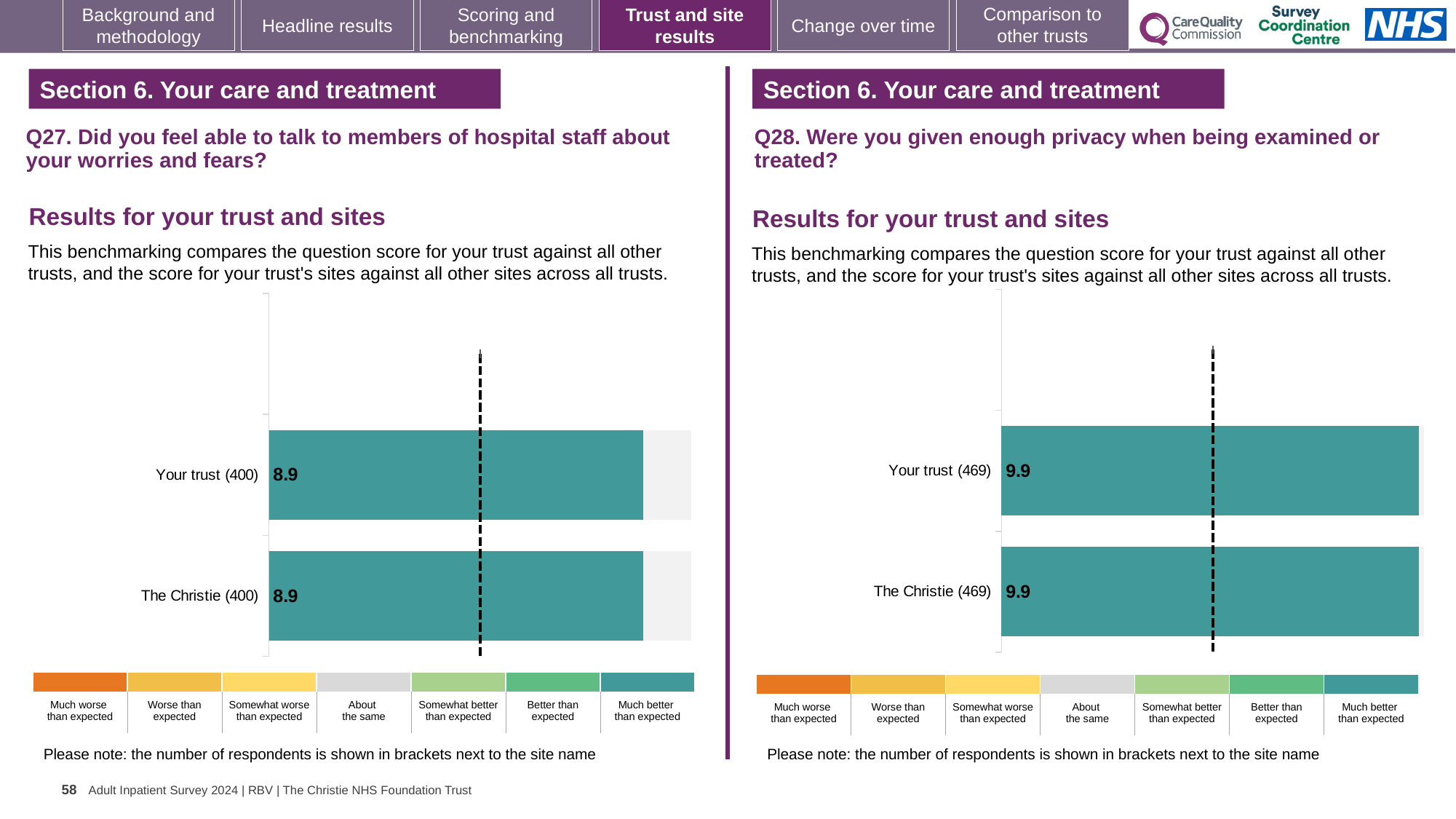
In the Q28 chart on the right, how many respondents are shown in brackets next to Your trust? 469 In the Q28 chart on the right, what is the difference between the score for Your trust and the score for The Christie? 0.0 How many bars are plotted in the Q27 chart on the left? 2 In the Q28 chart on the right, what is the score for The Christie (469)? 9.9 In the Q27 chart on the left, what is the score for Your trust (400)? 8.9 How many bars are plotted in the Q28 chart on the right? 2 What kind of chart is used for the Q27 results on the left? Bar chart In the Q27 chart on the left, what is the score for The Christie (400)? 8.9 In the Q27 chart on the left, what is the difference between the score for Your trust and the score for The Christie? 0.0 In the Q28 chart on the right, what is the score for Your trust (469)? 9.9 According to the colour key below the Q28 chart on the right, which benchmark category does the teal colour of the bars represent? Much better than expected In the Q27 chart on the left, how many respondents are shown in brackets next to The Christie? 400